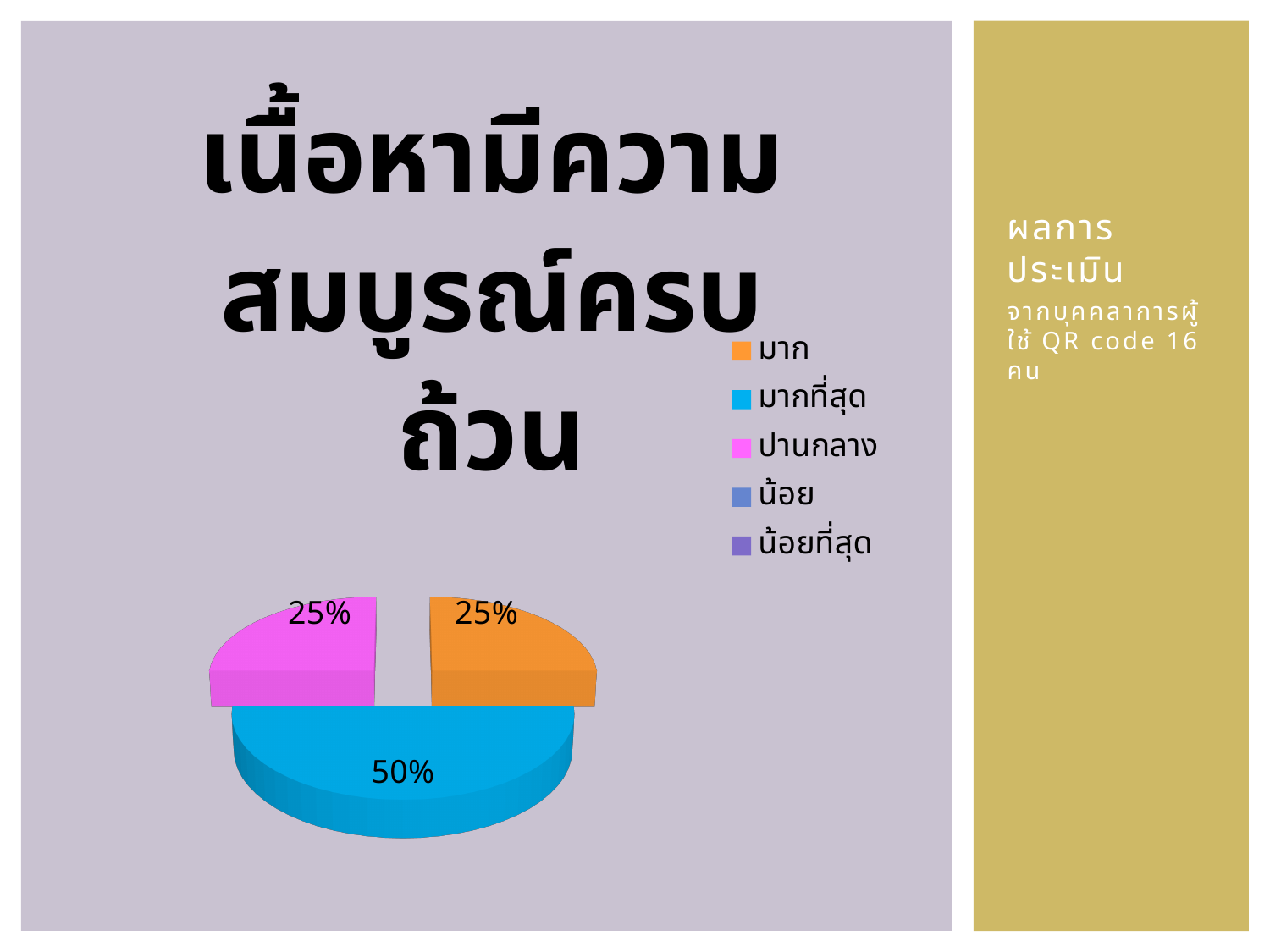
What is the title of the chart? เนื้อหามีความสมบูรณ์ครบถ้วน What is the difference between the percentage for มากที่สุด and the percentage for ปานกลาง? 25% What colour is the slice for มากที่สุด? blue How many entries does the chart's legend list? 5 What percentage is shown for มากที่สุด? 50% Which category has the largest slice of the pie? มากที่สุด What kind of chart is shown on the slide? pie chart What share of the pie does มากที่สุด take? 50% What percentage is shown for ปานกลาง? 25% Which is larger, the slice for มากที่สุด or the slice for มาก? มากที่สุด How many slices with data labels are visible in the pie chart? 3 What percentage is shown for มาก? 25%